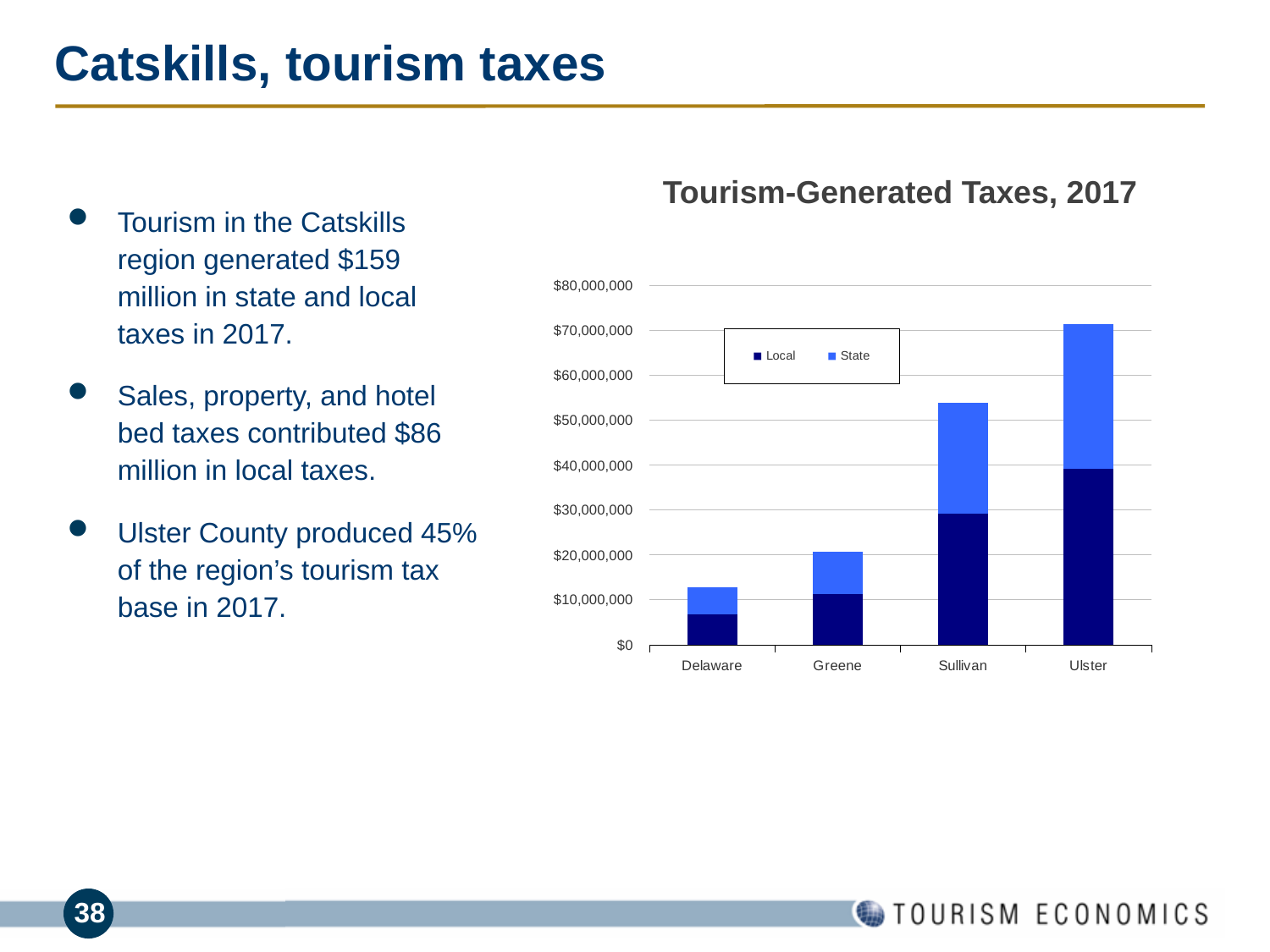
Which series is shown in the darker blue colour in the chart? Local Is the total value for Delaware greater or less than $20,000,000? less Which county has a larger total bar, Sullivan or Greene? Sullivan Is the Local value for Ulster greater or less than $30,000,000? greater What kind of chart is shown on the slide? Stacked bar chart Do the total bar heights rise or fall moving from Delaware to Ulster along the x axis? Rise Which county has the highest total tourism-generated taxes in the chart? Ulster What is the title of the chart? Tourism-Generated Taxes, 2017 How many series does the chart's legend list? 2 How many counties are shown on the x axis of the chart? 4 Which county has the lowest total tourism-generated taxes in the chart? Delaware Is the total value for Ulster greater or less than $60,000,000? greater